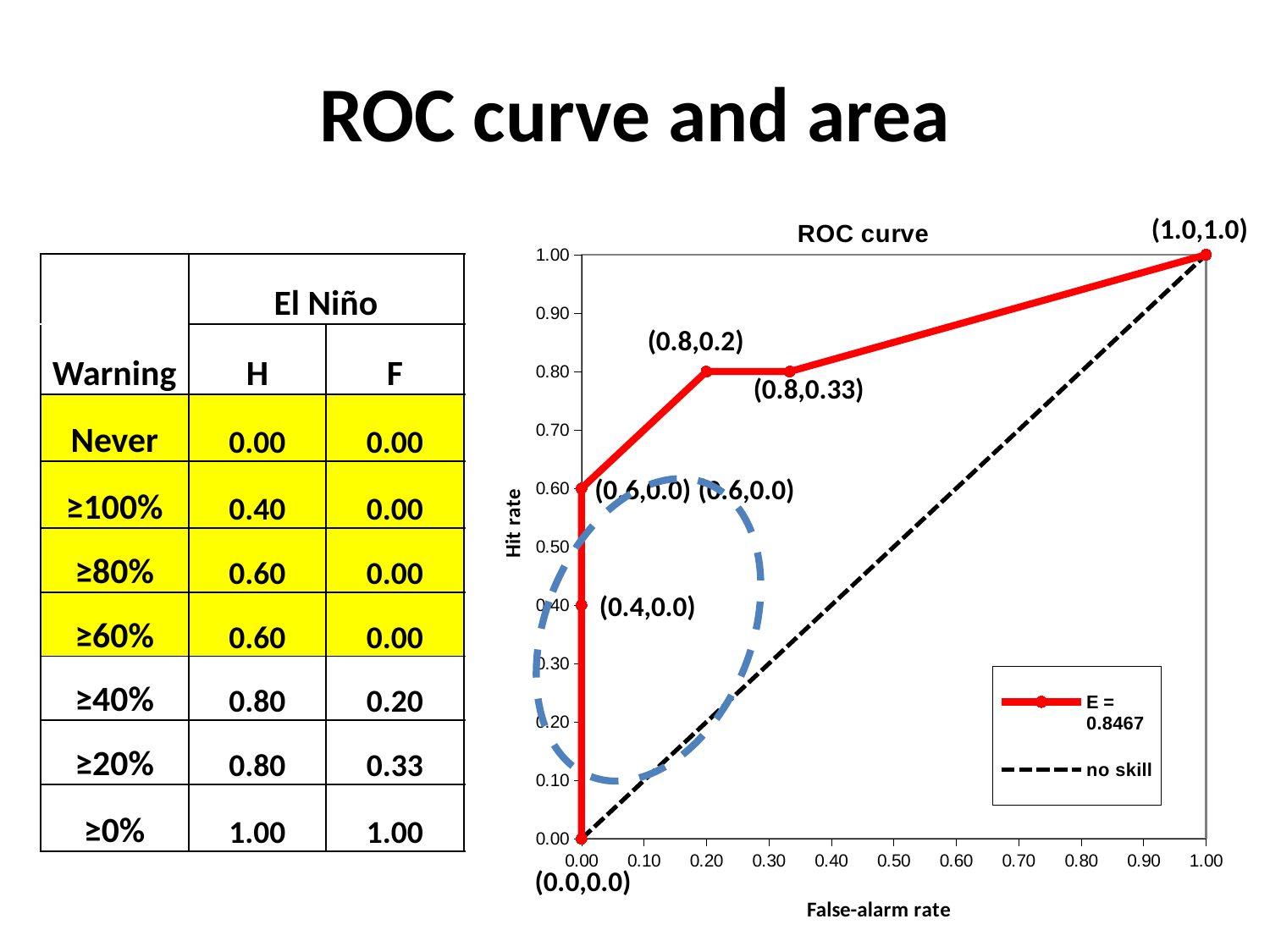
What is the hit rate of the ROC curve at a false-alarm rate of 0.33? 0.80 What is the hit rate of the ROC curve at a false-alarm rate of 0.20? 0.80 What is the title of the chart? ROC curve What is the difference between the hit rate at the point (1.0,1.0) and the hit rate at the point labelled (0.8,0.2)? 0.2 Is the hit rate of the ROC curve at a false-alarm rate of 0.20 greater or less than 0.70? greater What kind of chart is shown on the slide? line chart Does the hit rate of the ROC curve rise or fall as the false-alarm rate increases from 0.00 to 1.00? rise What is the lowest hit rate plotted on the ROC curve? 0.00 How many series does the chart's legend list? 2 What is the highest hit rate reached by the ROC curve? 1.00 At a false-alarm rate of 0.20, which line is higher: the ROC curve (E = 0.8467) or the no skill line? the ROC curve (E = 0.8467) What is the label of the x axis of the chart? False-alarm rate